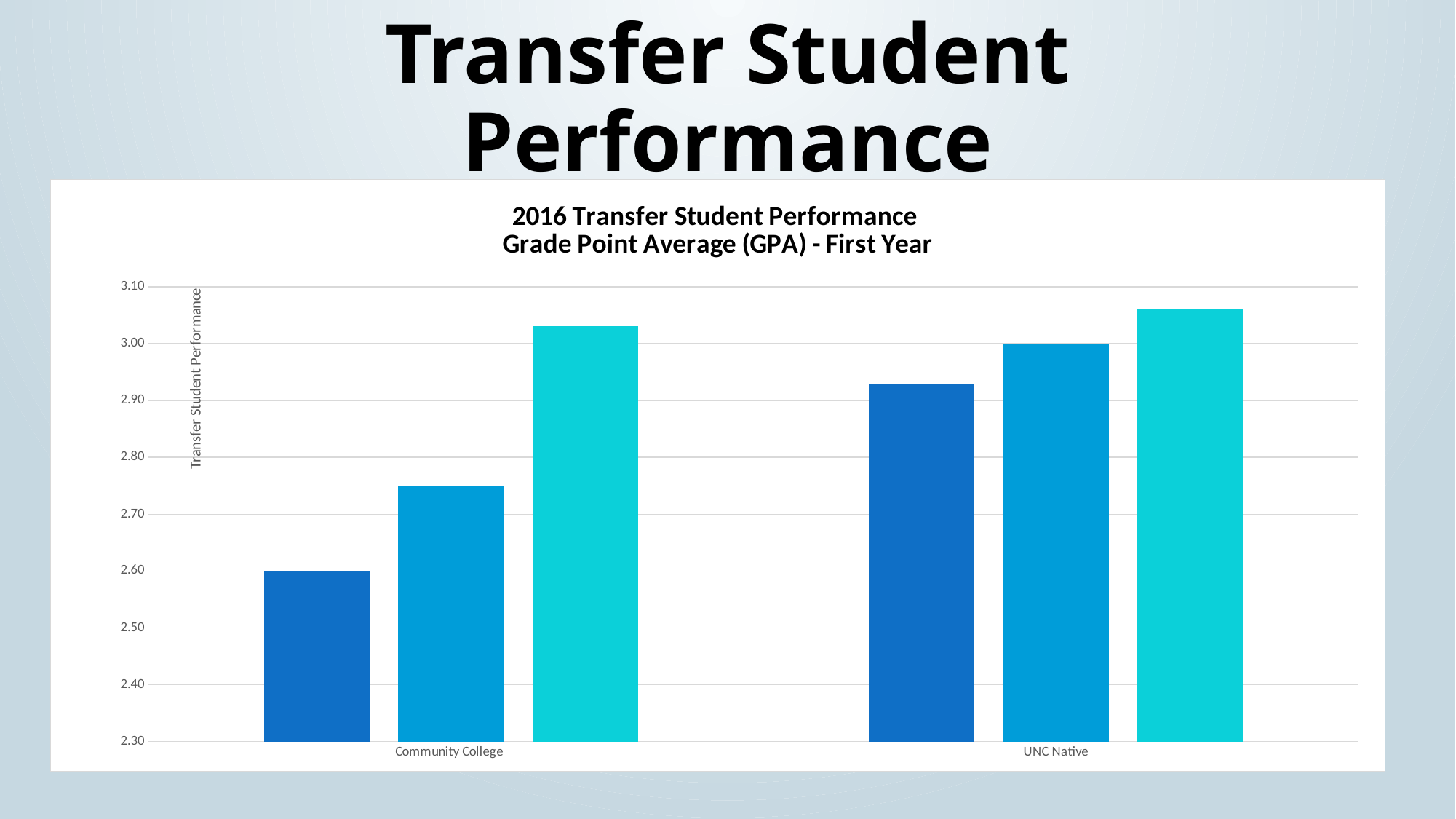
What is the value of the first (dark blue) bar for Community College? 2.60 What is the title of the chart? 2016 Transfer Student Performance Grade Point Average (GPA) - First Year How many bars are plotted for each category? 3 Which is larger: the first (dark blue) bar for Community College or the first (dark blue) bar for UNC Native? UNC Native What type of chart is shown on the slide? bar chart Is the value of the first (dark blue) bar for UNC Native greater or less than 2.90? greater Is the value of the second (medium blue) bar for Community College greater or less than 2.80? less What is the value of the second (medium blue) bar for UNC Native? 3.00 How many categories are shown on the x axis? 2 Is the value of the third (cyan) bar for Community College greater or less than 3.00? greater What is the label on the vertical axis? Transfer Student Performance Which category has the lowest bar in the chart? Community College